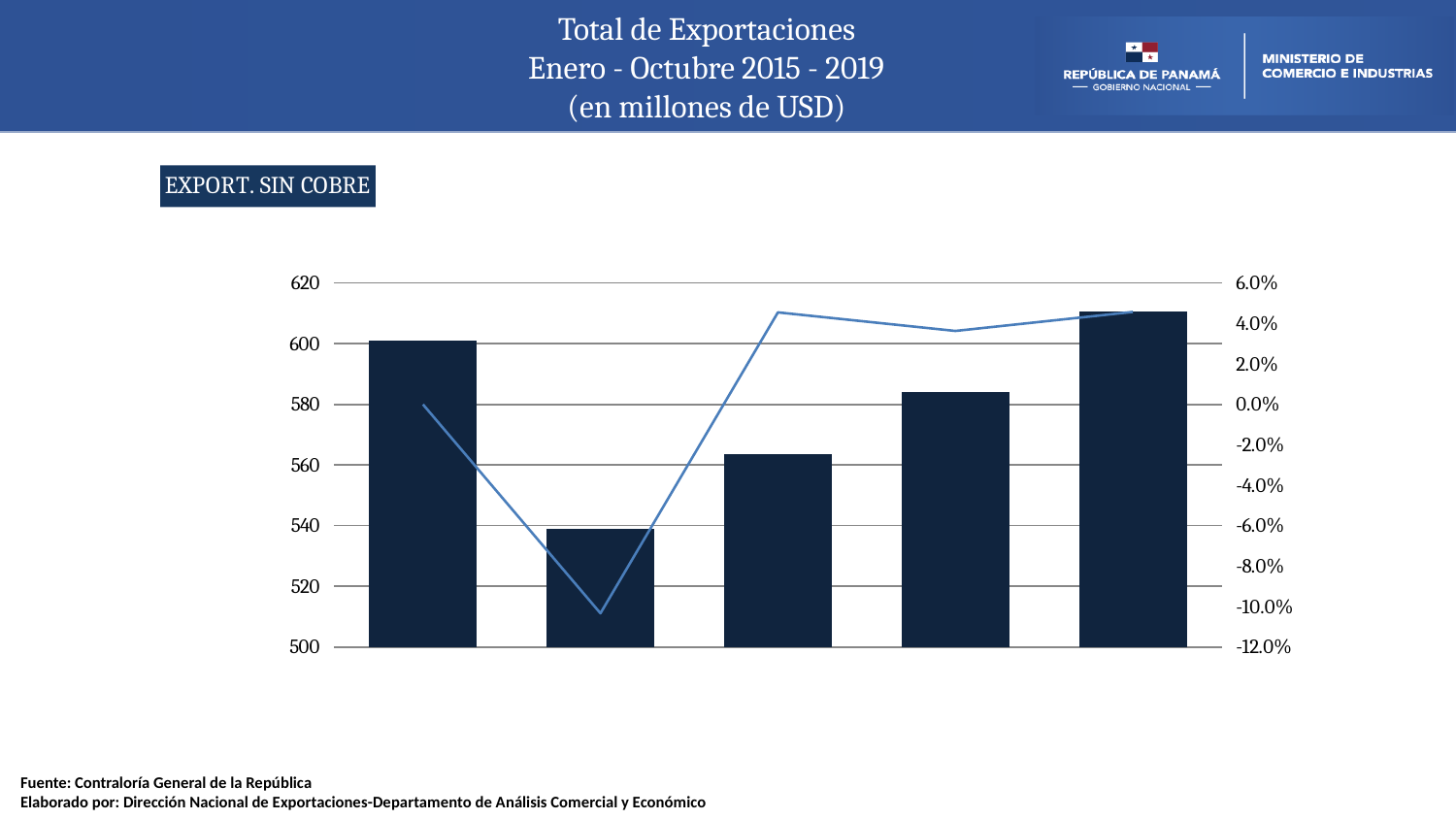
On the right axis, is the second point of the line greater or less than -8.0%? less Is the value of the second bar greater or less than 560? less From the second bar to the fifth bar, do the bar values rise or fall? rise Is the value of the first bar greater or less than 580? greater Which bar is the tallest in the chart? The fifth (rightmost) bar How many bars are plotted in the chart? 5 What kind of chart is shown on the slide? A combined bar and line chart Which is larger, the third bar or the fourth bar? The fourth bar What is the title shown above the chart? EXPORT. SIN COBRE Which bar is the shortest in the chart? The second bar